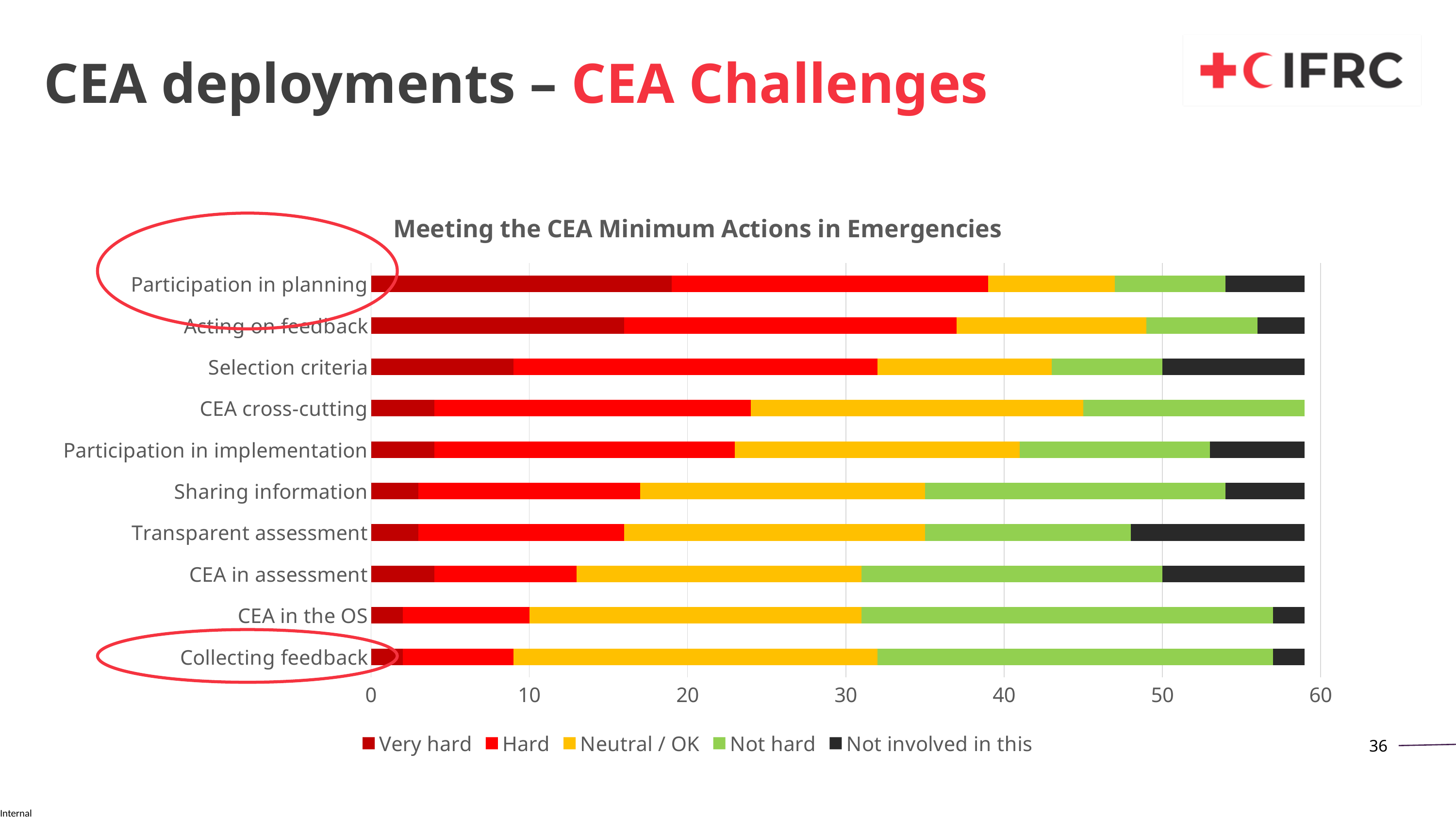
Which category has no 'Not involved in this' segment? CEA cross-cutting Is the 'Very hard' value for Acting on feedback greater or less than 10? greater Is the 'Very hard' value for Participation in planning greater or less than 10? greater How many series does the legend list? 5 What kind of chart is shown on the slide? Stacked bar chart Which is larger: the 'Very hard' value for Participation in planning or for Collecting feedback? Participation in planning Is the 'Very hard' value for Collecting feedback greater or less than 10? less Which category has the largest 'Very hard' segment? Participation in planning How many categories are plotted on the chart? 10 What is the title of the chart? Meeting the CEA Minimum Actions in Emergencies Which is larger: the 'Hard' value for Selection criteria or for CEA in the OS? Selection criteria